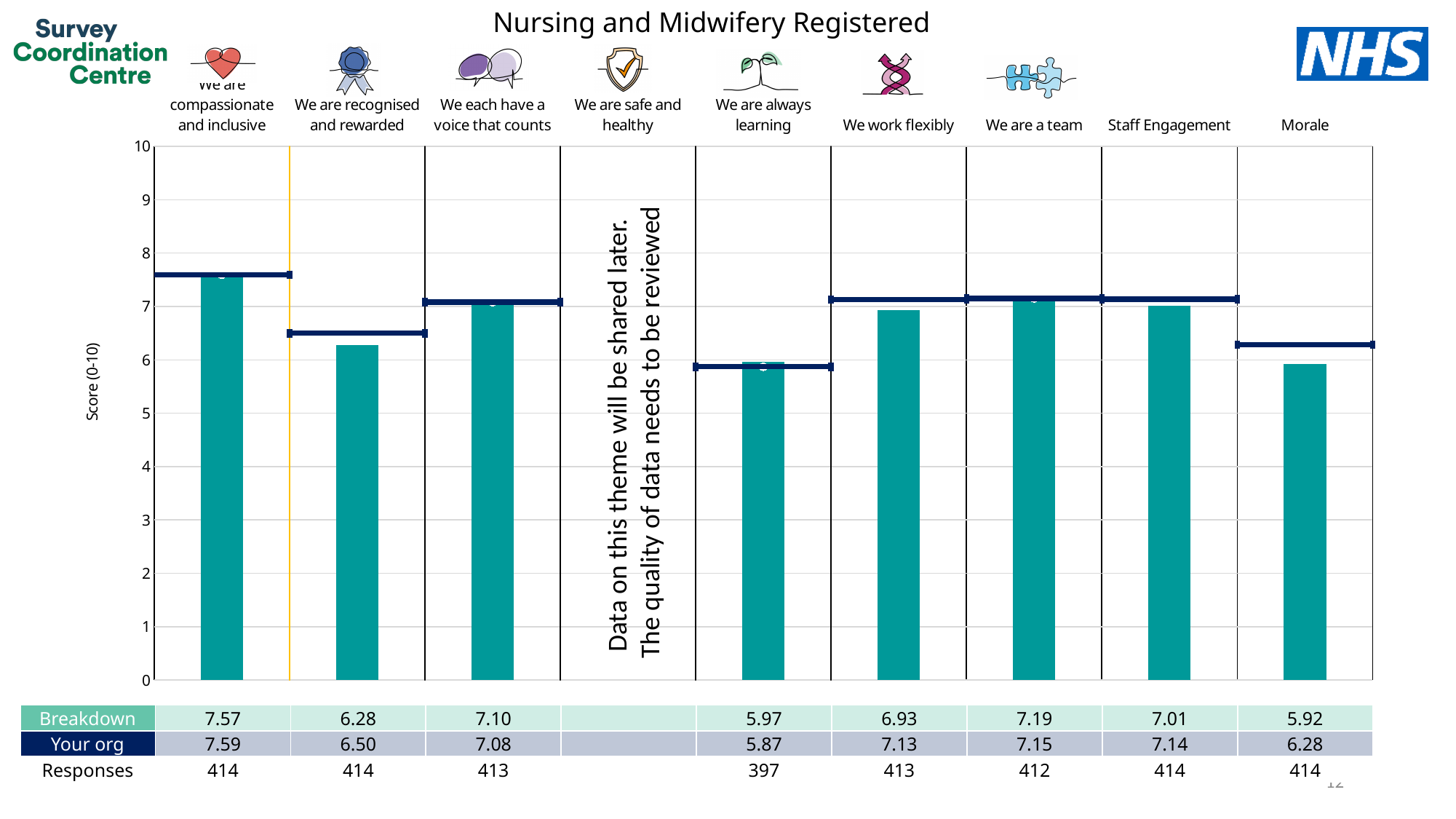
What is the difference between the Your org score and the Breakdown score for 'Morale'? 0.36 Which theme has the lowest Breakdown score? Morale What is the Your org score for 'Morale'? 6.28 How many responses are recorded for 'We are always learning'? 397 What is the title of the chart? Nursing and Midwifery Registered Which theme has no data plotted on the chart? We are safe and healthy What is the Breakdown score for 'We are compassionate and inclusive'? 7.57 Is the Breakdown bar for 'We are recognised and rewarded' greater or less than 7? less Which theme has the highest Breakdown score? We are compassionate and inclusive For 'We work flexibly', which is larger: the Breakdown score or the Your org score? Your org What kind of chart is shown on the slide? bar chart How many themes have a bar plotted on the chart? 8